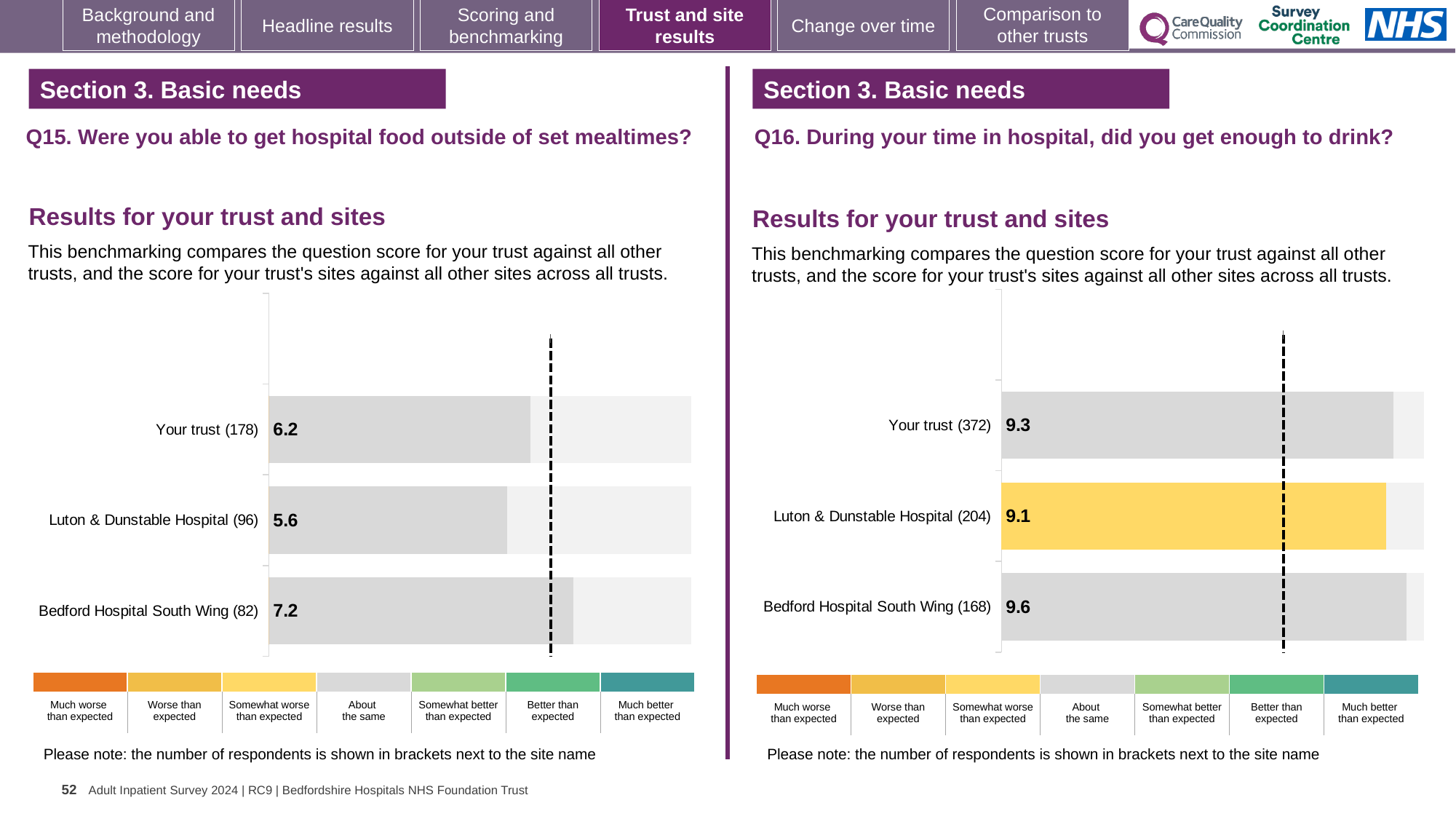
In the Q16 chart, which bar is coloured yellow rather than grey? Luton & Dunstable Hospital (204) In the Q15 chart (hospital food outside of set mealtimes), what is the score for Your trust (178)? 6.2 In the Q15 chart, what is the difference between the scores for Bedford Hospital South Wing and Luton & Dunstable Hospital? 1.6 In the Q16 chart, which has the larger score: Your trust or Bedford Hospital South Wing? Bedford Hospital South Wing What type of chart is used on the left side of the slide for Q15? Bar chart In the Q16 chart, what is the difference between the scores for Your trust and Luton & Dunstable Hospital? 0.2 In the Q15 chart, what is the score for Luton & Dunstable Hospital (96)? 5.6 In the Q16 chart, which site or trust has the lowest score? Luton & Dunstable Hospital (204) In the Q16 chart (did you get enough to drink), what is the score for Bedford Hospital South Wing (168)? 9.6 In the Q15 chart, which site or trust has the highest score? Bedford Hospital South Wing (82) How many bars are plotted in the Q15 chart? 3 In the Q16 chart, what is the score for Your trust (372)? 9.3